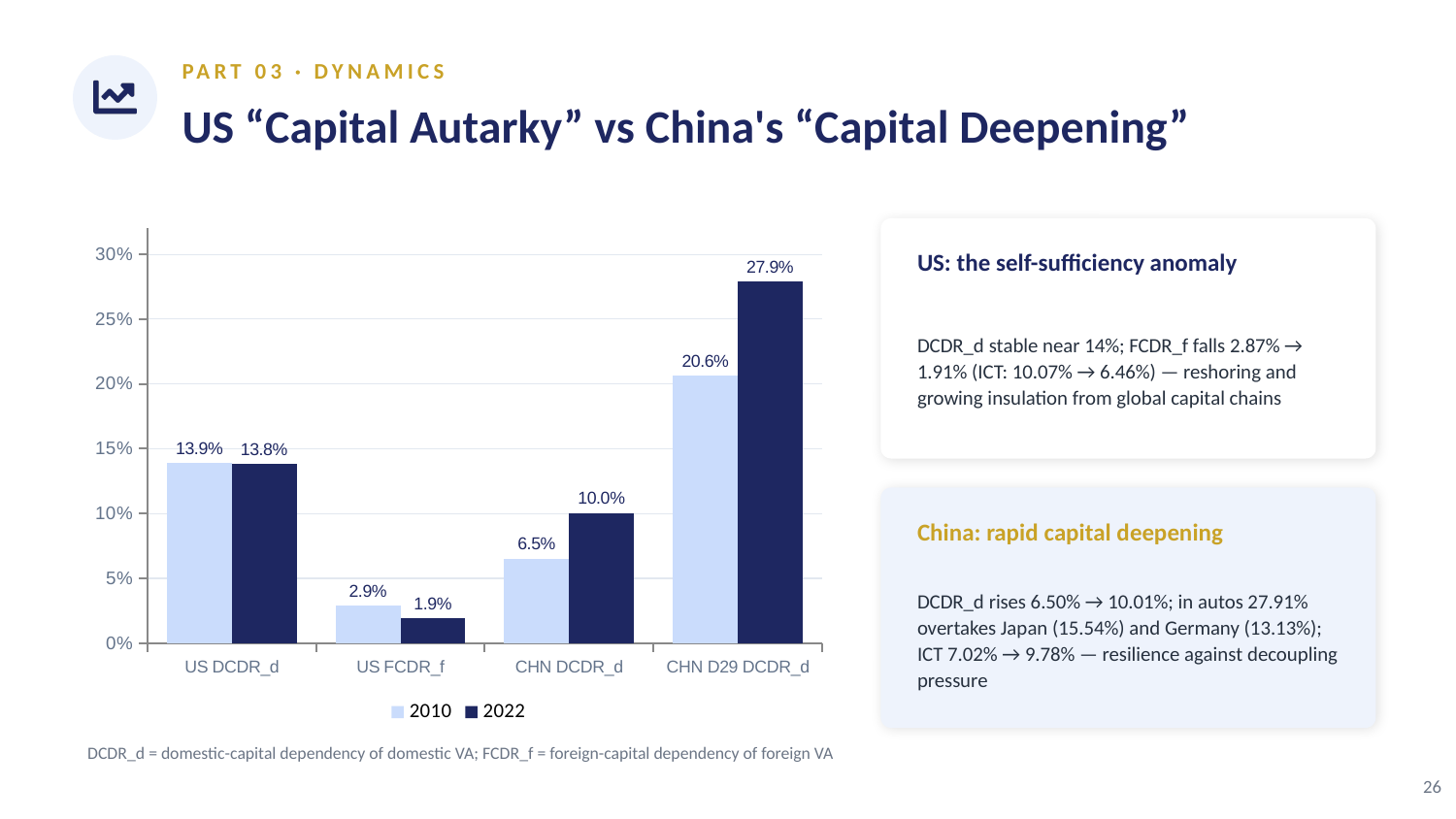
What is the 2022 value for CHN DCDR_d? 10.0% What kind of chart is shown on the slide? Bar chart How many categories are shown on the x axis? 4 Is the 2010 value for CHN D29 DCDR_d greater or less than 20%? greater What is the difference between the 2022 and 2010 values for CHN D29 DCDR_d? 7.3% What is the 2010 value for US FCDR_f? 2.9% Which category has the lowest 2010 value? US FCDR_f What is the 2022 value for CHN D29 DCDR_d? 27.9% Which is larger for CHN DCDR_d, the 2010 value or the 2022 value? 2022 Which category has the highest 2022 value? CHN D29 DCDR_d How many series does the legend list? 2 Which series is shown in dark navy in the legend? 2022